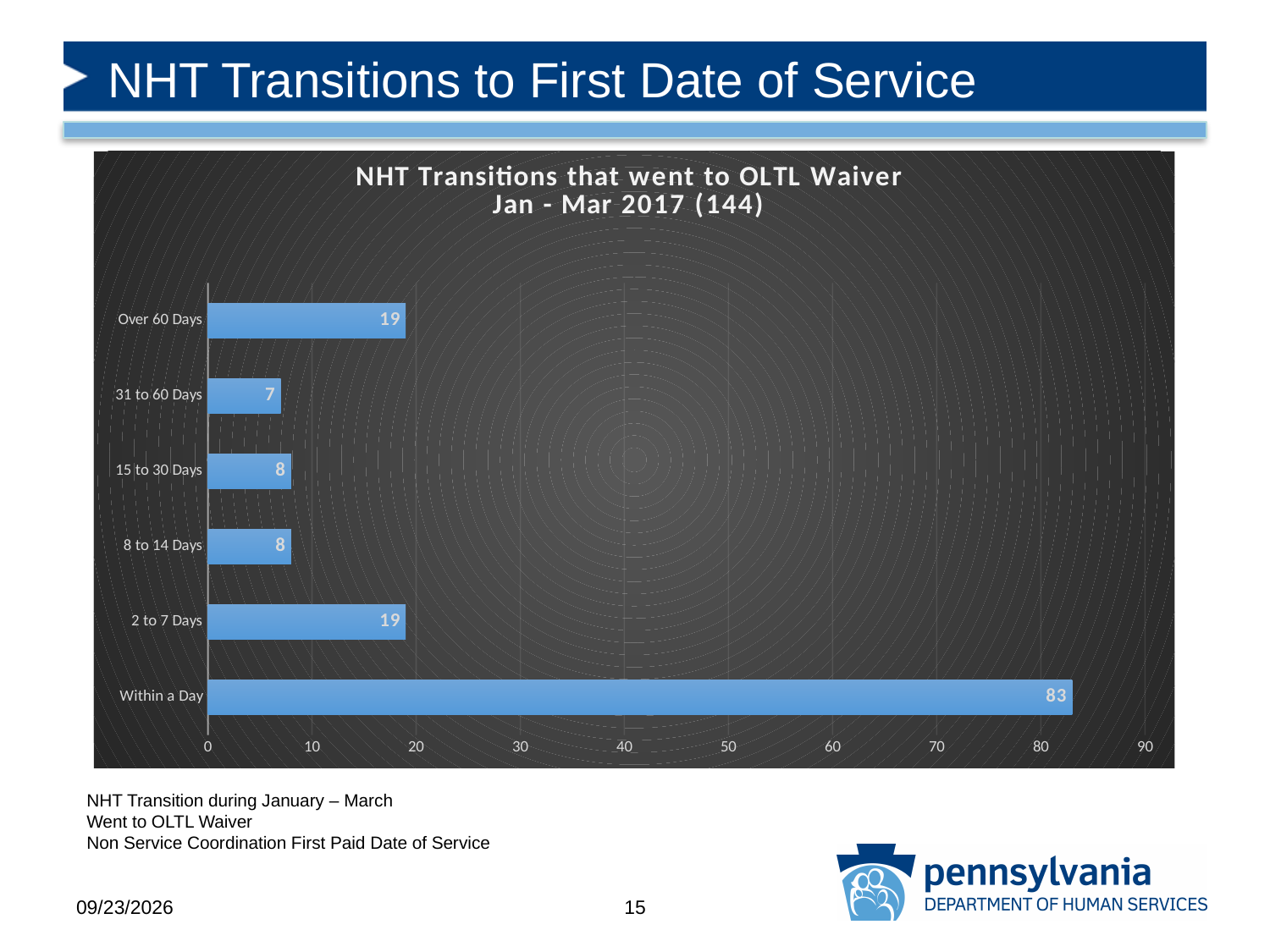
Which category has the lowest value? 31 to 60 Days What is the value for Within a Day? 83 Which category has the highest value? Within a Day What is the difference between the values for 8 to 14 Days and 31 to 60 Days? 1 What is the value for 31 to 60 Days? 7 Is the value for Within a Day greater or less than 80? greater Which is larger, the value for 15 to 30 Days or the value for 31 to 60 Days? 15 to 30 Days What is the value for Over 60 Days? 19 What kind of chart is shown on the slide? bar chart What is the title of the chart? NHT Transitions that went to OLTL Waiver Jan - Mar 2017 (144) How many categories are shown in the chart? 6 What is the difference between the values for Within a Day and 2 to 7 Days? 64